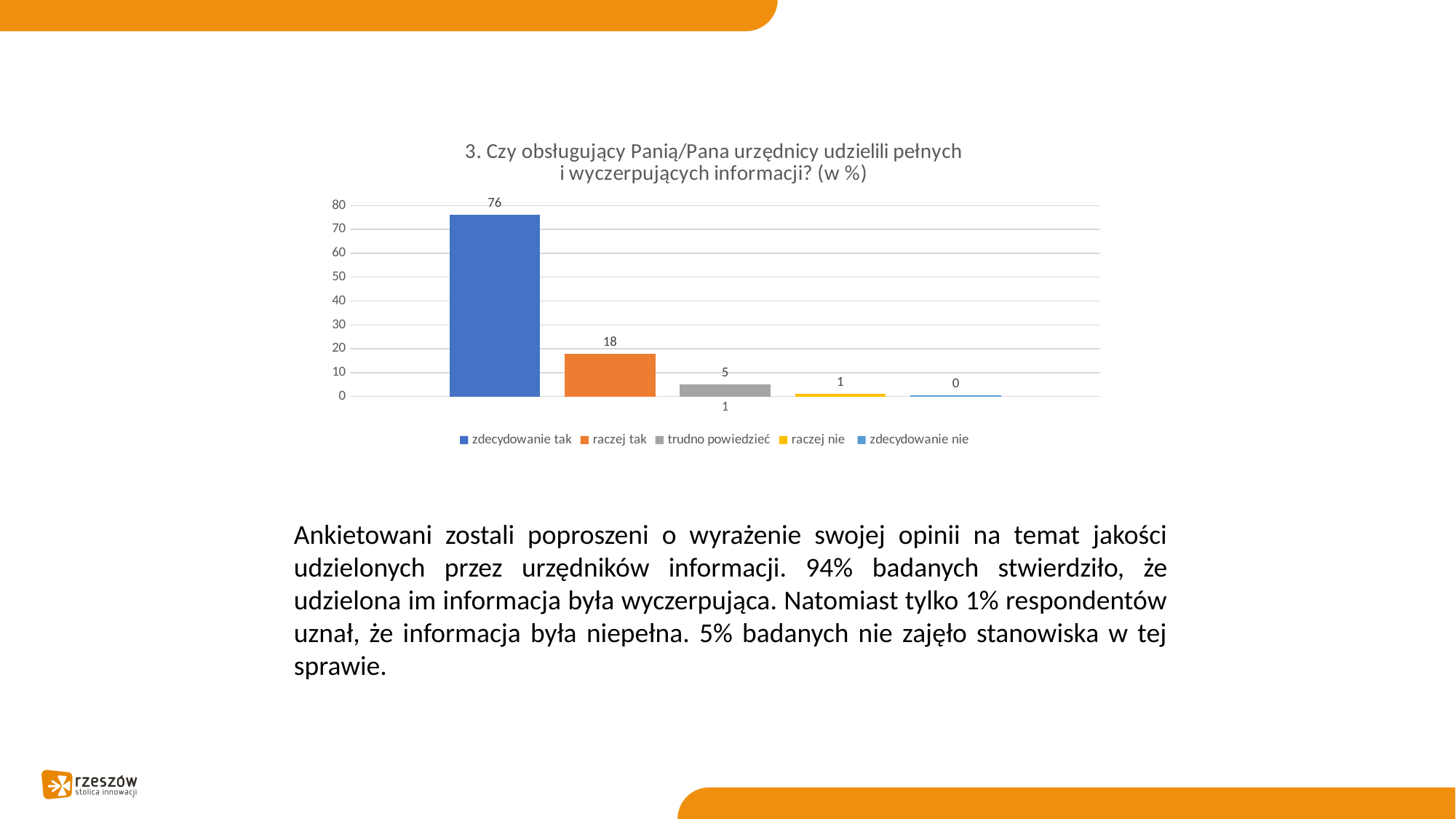
What colour is the bar for "raczej tak"? orange Which response has the highest value? zdecydowanie tak Which response has the lowest value? zdecydowanie nie What is the value for "raczej nie"? 1 What is the value for "zdecydowanie nie"? 0 What is the difference between the values for "zdecydowanie tak" and "raczej tak"? 58 What is the value for "raczej tak"? 18 What type of chart is shown on the slide? bar chart How many series does the legend list? 5 Which is larger, the value for "raczej tak" or the value for "trudno powiedzieć"? raczej tak What is the value for "zdecydowanie tak"? 76 What is the value for "trudno powiedzieć"? 5